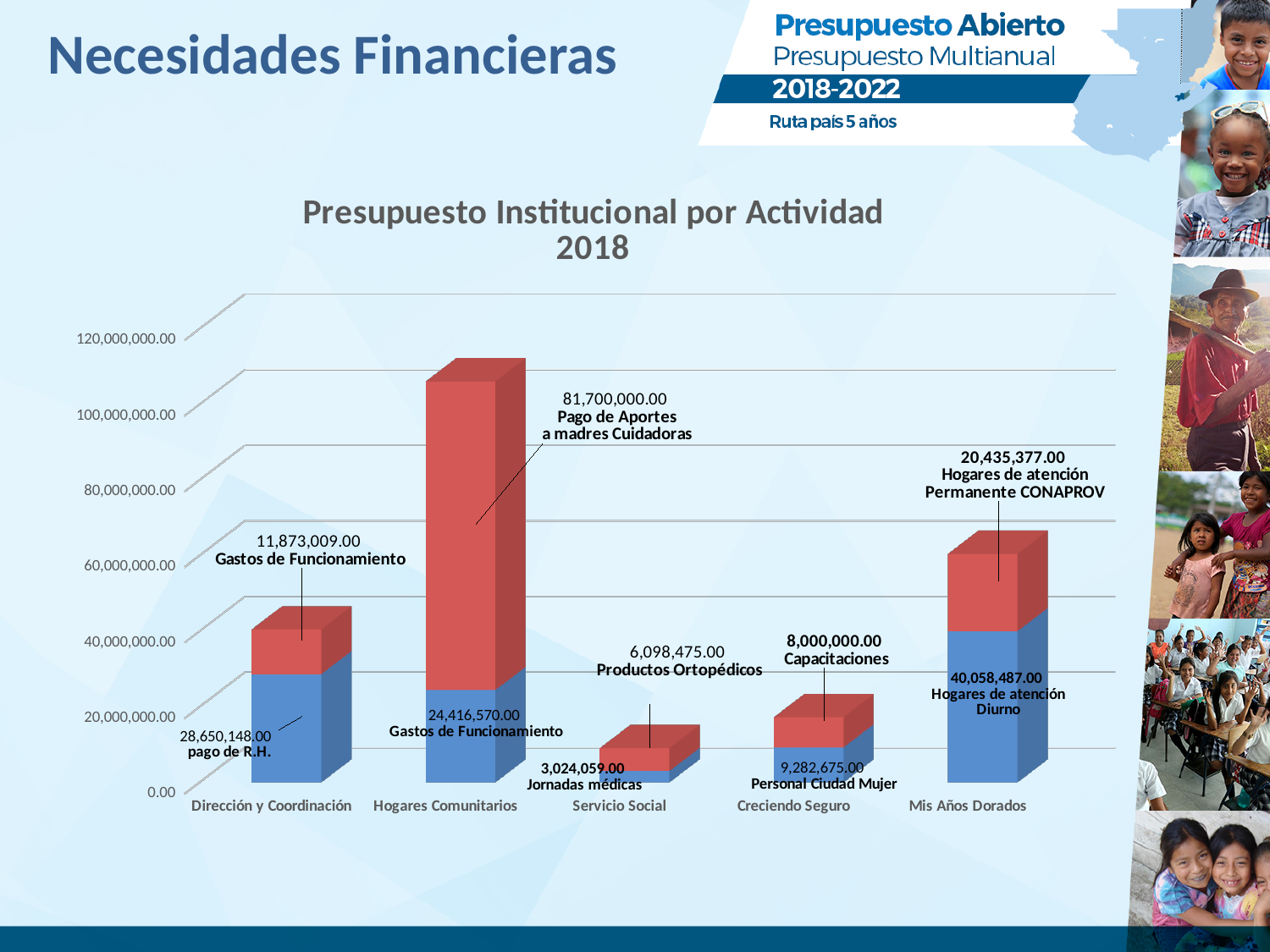
What is the difference between 'Hogares de atención Diurno' (40,058,487.00) and 'Hogares de atención Permanente CONAPROV' (20,435,377.00) for Mis Años Dorados? 19,623,110.00 What is the value labelled 'Hogares de atención Diurno' for Mis Años Dorados? 40,058,487.00 Which category has the tallest stacked bar? Hogares Comunitarios How many categories are shown on the x axis of the chart? 5 Which is larger for Creciendo Seguro: 'Personal Ciudad Mujer' or 'Capacitaciones'? Personal Ciudad Mujer What is the value labelled 'Pago de Aportes a madres Cuidadoras' for Hogares Comunitarios? 81,700,000.00 Which category has the shortest stacked bar? Servicio Social What is the total of the stacked bar for Servicio Social (Jornadas médicas plus Productos Ortopédicos)? 9,122,534.00 What is the value labelled 'pago de R.H.' for Dirección y Coordinación? 28,650,148.00 What kind of chart is shown on the slide? Stacked bar chart What is the value labelled 'Capacitaciones' for Creciendo Seguro? 8,000,000.00 What is the title of the chart? Presupuesto Institucional por Actividad 2018